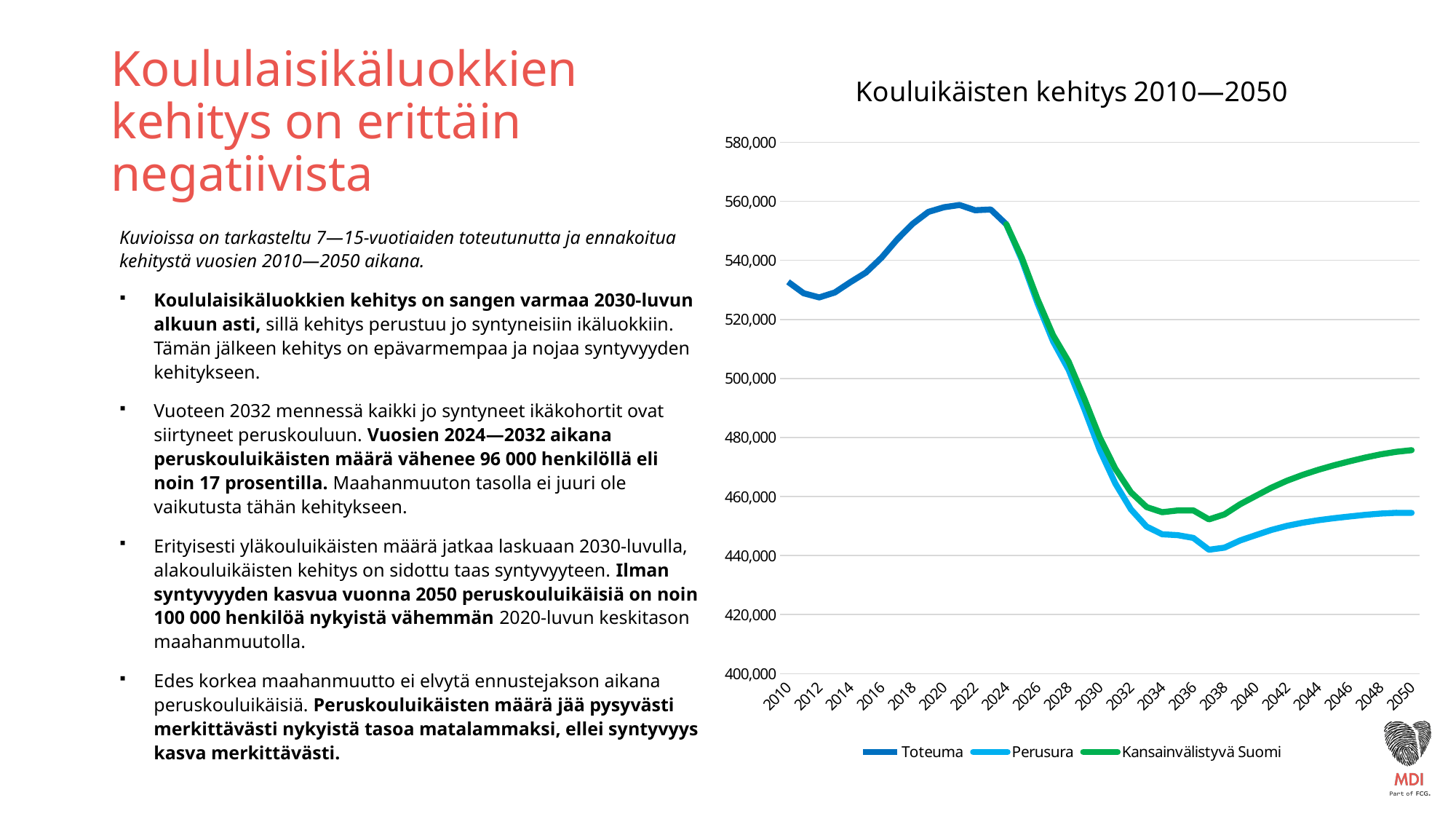
In 2050, which series has the higher value, Perusura or Kansainvälistyvä Suomi? Kansainvälistyvä Suomi Which series in the chart is drawn in green? Kansainvälistyvä Suomi How many year labels are shown on the x axis of the chart? 21 What kind of chart is shown on the slide? line chart Is the value of Perusura in 2050 greater or less than 460,000? less Is the value of Toteuma in 2010 greater or less than 520,000? greater Is the value of Toteuma in 2022 greater or less than 540,000? greater What is the title of the chart? Kouluikäisten kehitys 2010—2050 How many series does the legend of the chart list? 3 Does the Perusura series rise or fall between 2024 and 2038? fall